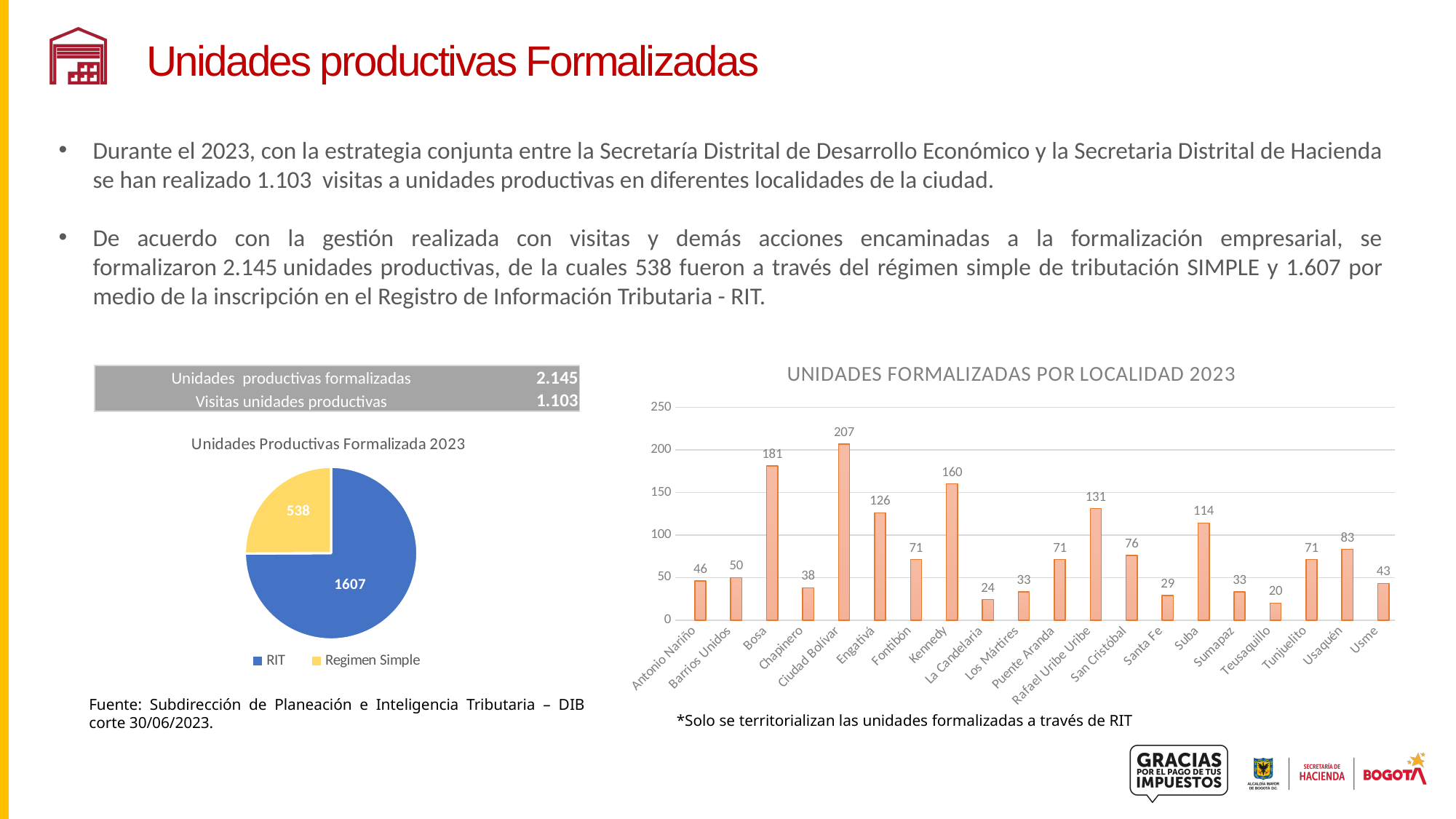
In the bar chart 'UNIDADES FORMALIZADAS POR LOCALIDAD 2023', which locality has the highest value? Ciudad Bolívar In the bar chart 'UNIDADES FORMALIZADAS POR LOCALIDAD 2023', what is the difference between Ciudad Bolívar and Bosa? 26 In the bar chart 'UNIDADES FORMALIZADAS POR LOCALIDAD 2023', which is larger, Suba or Rafael Uribe Uribe? Rafael Uribe Uribe In the pie chart 'Unidades Productivas Formalizada 2023', what is the value for Regimen Simple? 538 In the bar chart 'UNIDADES FORMALIZADAS POR LOCALIDAD 2023', what is the value for Ciudad Bolívar? 207 What kind of chart is 'Unidades Productivas Formalizada 2023'? pie chart In the bar chart 'UNIDADES FORMALIZADAS POR LOCALIDAD 2023', what is the value for Kennedy? 160 In the bar chart 'UNIDADES FORMALIZADAS POR LOCALIDAD 2023', how many localities are shown? 20 In the bar chart 'UNIDADES FORMALIZADAS POR LOCALIDAD 2023', is the value for Engativá greater or less than 100? greater In the pie chart 'Unidades Productivas Formalizada 2023', what is the difference between RIT and Regimen Simple? 1069 In the pie chart 'Unidades Productivas Formalizada 2023', how many entries does the legend list? 2 In the bar chart 'UNIDADES FORMALIZADAS POR LOCALIDAD 2023', which locality has the lowest value? Teusaquillo